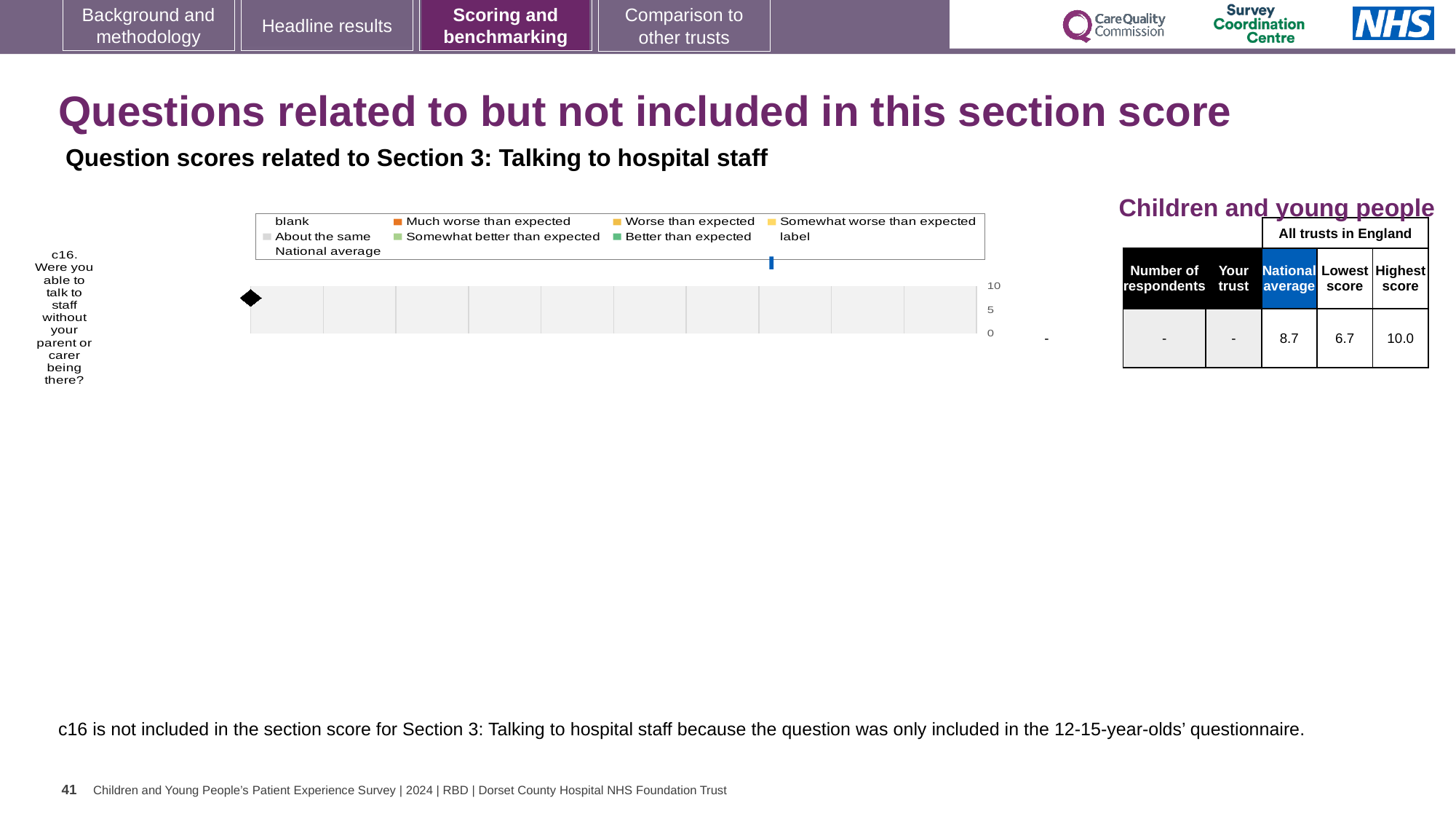
In the table, what is the lowest score among all trusts in England for c16? 6.7 What kind of chart is shown on the slide? bar chart Is the national average score for c16 in the table greater or less than 5? greater Which question is plotted on the chart? c16. Were you able to talk to staff without your parent or carer being there? What is the difference between the highest score and the lowest score in the table for c16? 3.3 Which is larger in the table for c16: the national average or the lowest score? national average How many question categories are plotted on the chart? 1 What is the highest value shown on the chart's axis? 10 In the table, what is shown for 'Your trust' for c16? - How many entries does the chart legend list? 9 In the table, what is the highest score among all trusts in England for c16? 10.0 In the table, what is the national average score for c16? 8.7